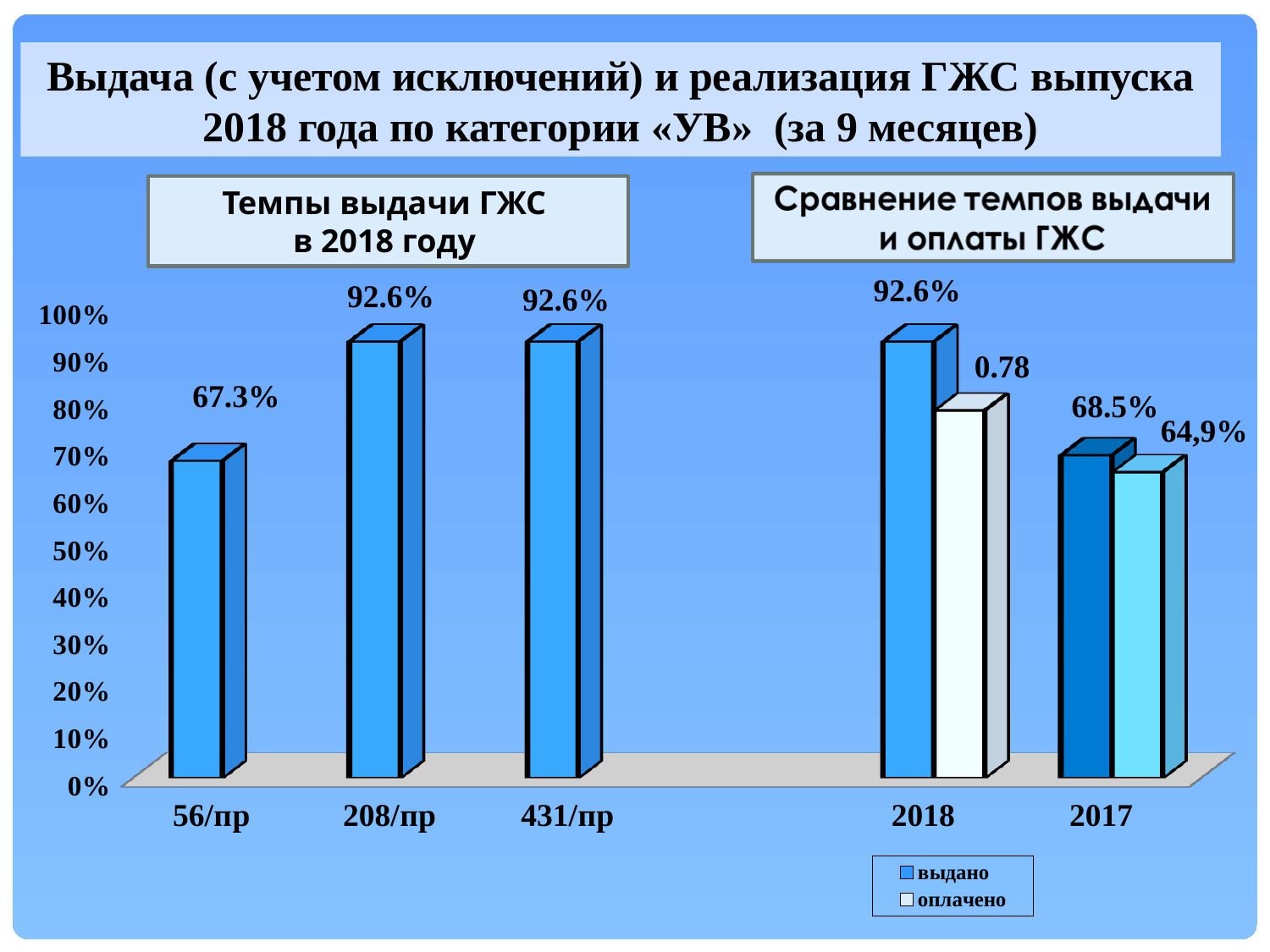
In the chart 'Сравнение темпов выдачи и оплаты ГЖС', is the 'оплачено' value for 2018 greater or less than 70%? greater What kind of chart is used on this slide? Bar chart In the chart 'Темпы выдачи ГЖС в 2018 году', how many categories are shown on the x axis? 3 In the chart 'Темпы выдачи ГЖС в 2018 году', which category has the lowest value? 56/пр In the chart 'Сравнение темпов выдачи и оплаты ГЖС', what is the 'оплачено' value for 2017? 64,9% In the chart 'Сравнение темпов выдачи и оплаты ГЖС', what is the 'выдано' value for 2017? 68.5% In the chart 'Сравнение темпов выдачи и оплаты ГЖС', how many series does the legend list? 2 In the chart 'Сравнение темпов выдачи и оплаты ГЖС', which is larger for 2017: 'выдано' or 'оплачено'? выдано In the chart 'Темпы выдачи ГЖС в 2018 году', what is the value for 208/пр? 92.6% In the chart 'Сравнение темпов выдачи и оплаты ГЖС', what is the 'выдано' value for 2018? 92.6% In the chart 'Темпы выдачи ГЖС в 2018 году', what is the difference between the values for 208/пр and 56/пр? 25.3% In the chart 'Темпы выдачи ГЖС в 2018 году', what is the value for 56/пр? 67.3%